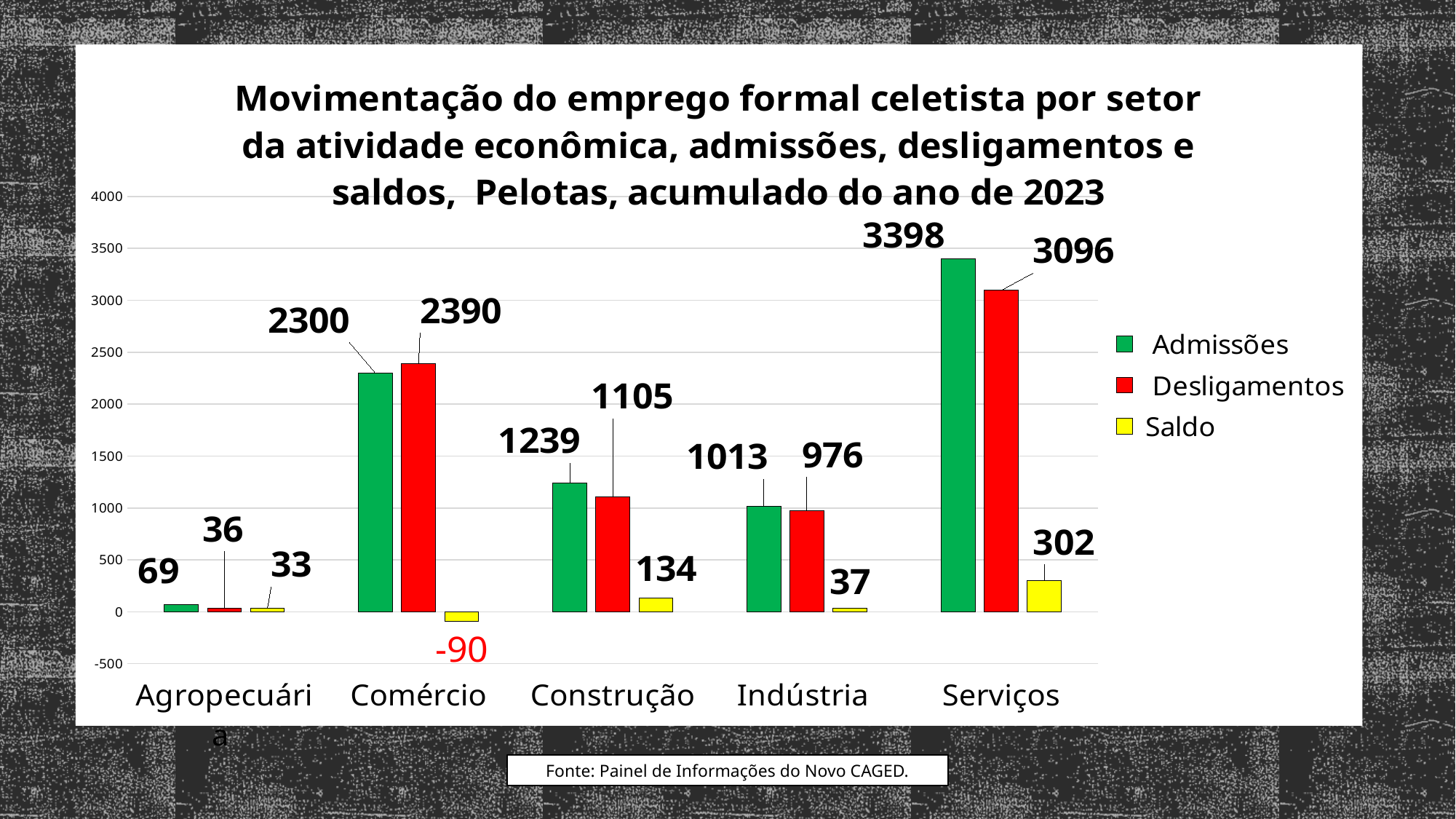
Which sector has the lowest Desligamentos value? Agropecuária What is the Saldo value for Comércio? -90 How many series does the legend list? 3 How many sectors are shown on the x axis? 5 What is the value of Desligamentos for Comércio? 2390 What is the difference between Admissões and Desligamentos for Construção? 134 Which colour represents the Saldo series? Yellow What is the value of Admissões for Serviços? 3398 Which sector has the highest Admissões value? Serviços Which is larger for Comércio, Admissões or Desligamentos? Desligamentos What kind of chart is shown on the slide? Bar chart What is the value of Desligamentos for Indústria? 976